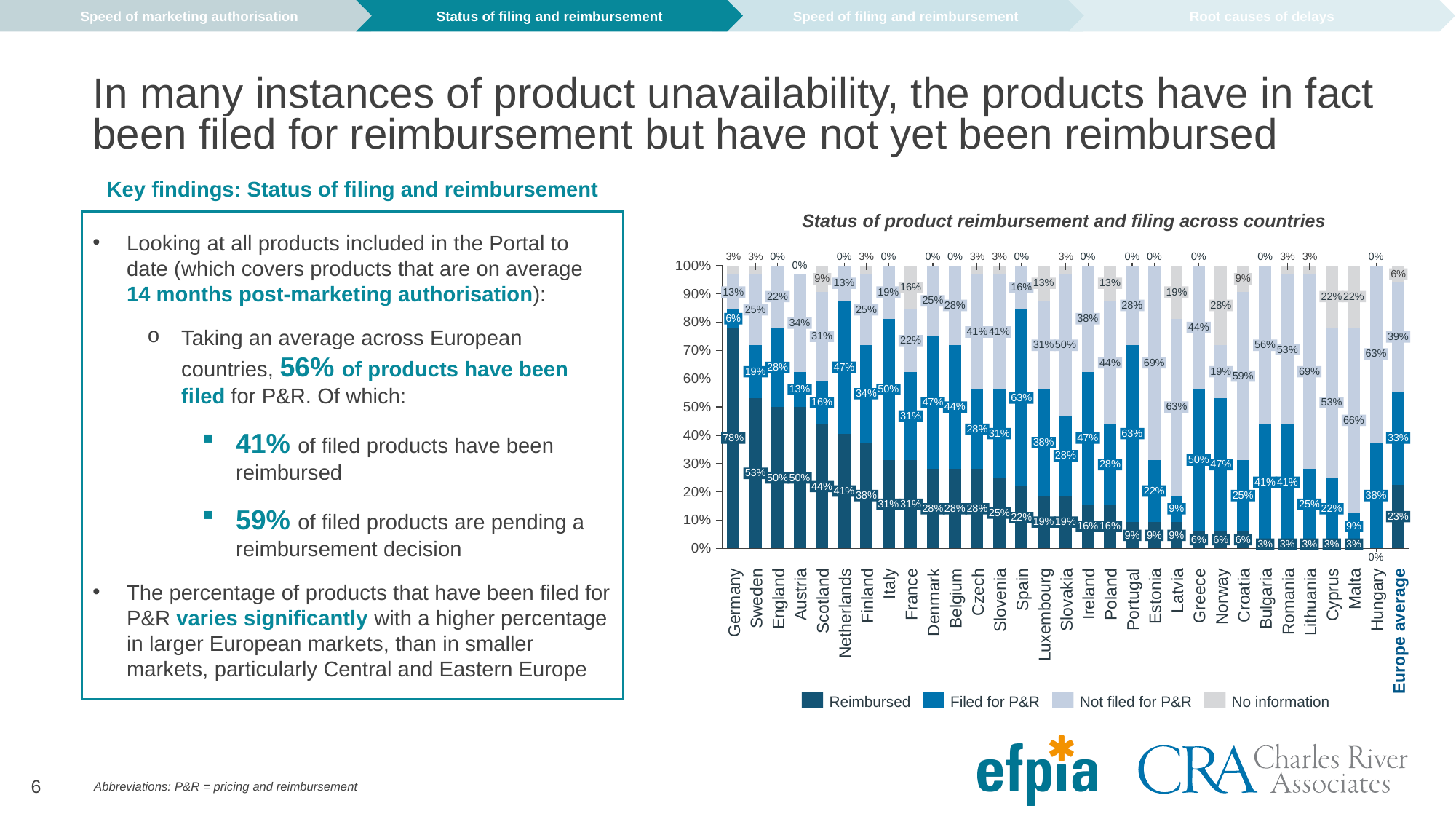
What is the difference between the Reimbursed percentages of Germany and Sweden? 25 percentage points What is the Filed for P&R percentage for the Europe average bar? 33% What is the Filed for P&R percentage for Spain? 63% What is the title of the chart? Status of product reimbursement and filing across countries Which country has the highest Reimbursed percentage? Germany How many series does the chart legend list? 4 What kind of chart is shown on the slide? Stacked bar chart Which has a larger Filed for P&R percentage, Italy or the Netherlands? Italy What is the Reimbursed percentage for Hungary? 38% What is the No information percentage for Norway? 28% How many bars (countries plus the Europe average) are plotted on the chart? 31 What percentage of products in Germany are shown as Reimbursed? 78%